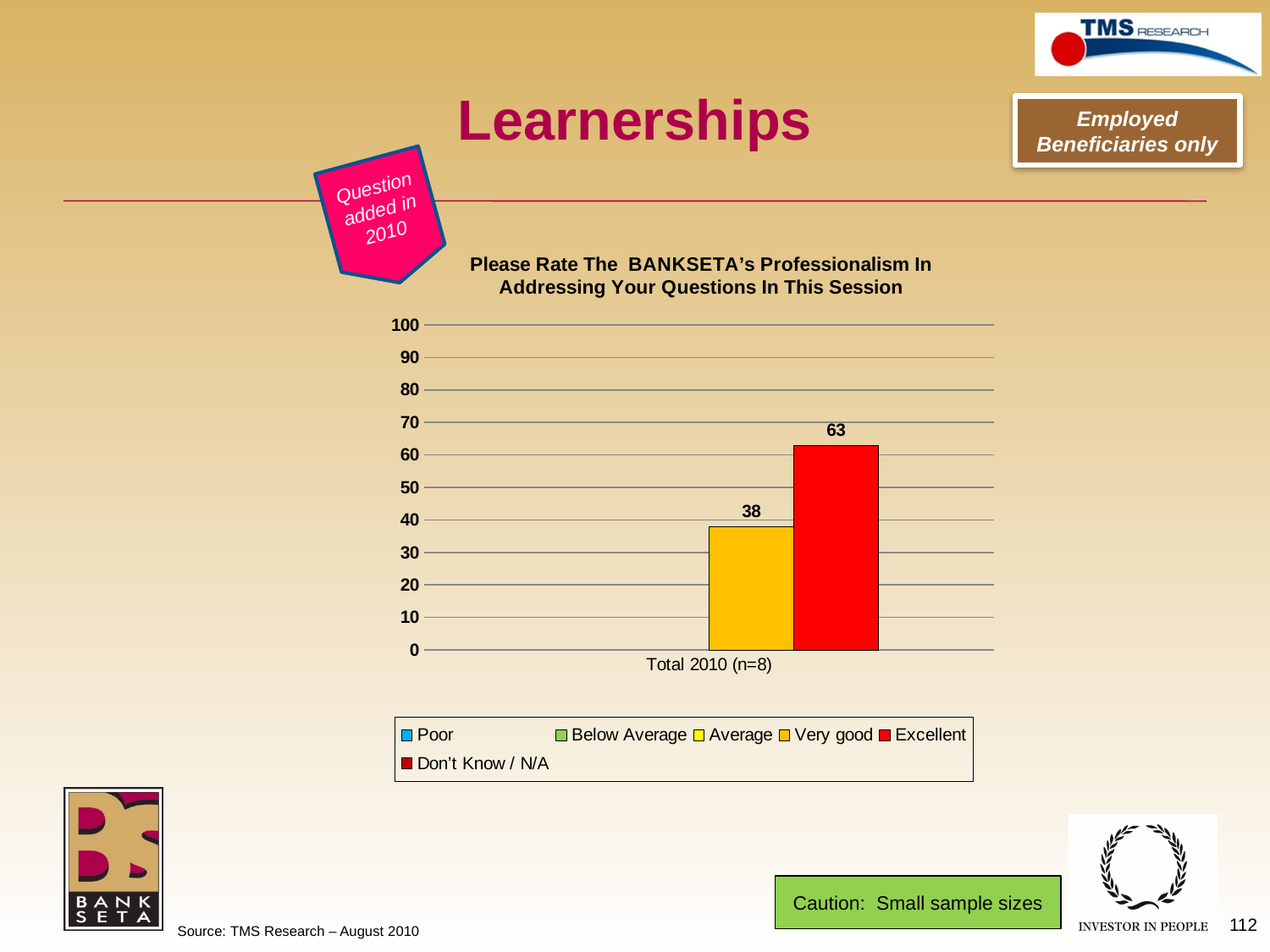
What is the difference between the two plotted values, 63 and 38? 25 What is the value of the red bar for Total 2010 (n=8)? 63 Which of the two plotted bars is taller, the orange bar or the red bar? the red bar What kind of chart is shown on the slide? bar chart How many categories are shown on the x axis? 1 How many series does the legend list? 6 What is the label of the category on the x axis? Total 2010 (n=8) Is the value of the orange bar greater or less than 40? less What value is shown for Excellent in the Total 2010 (n=8) category? 63 What is the maximum value shown on the y axis? 100 Is the value of the red bar greater or less than 60? greater What is the value of the shorter, orange bar for Total 2010 (n=8)? 38